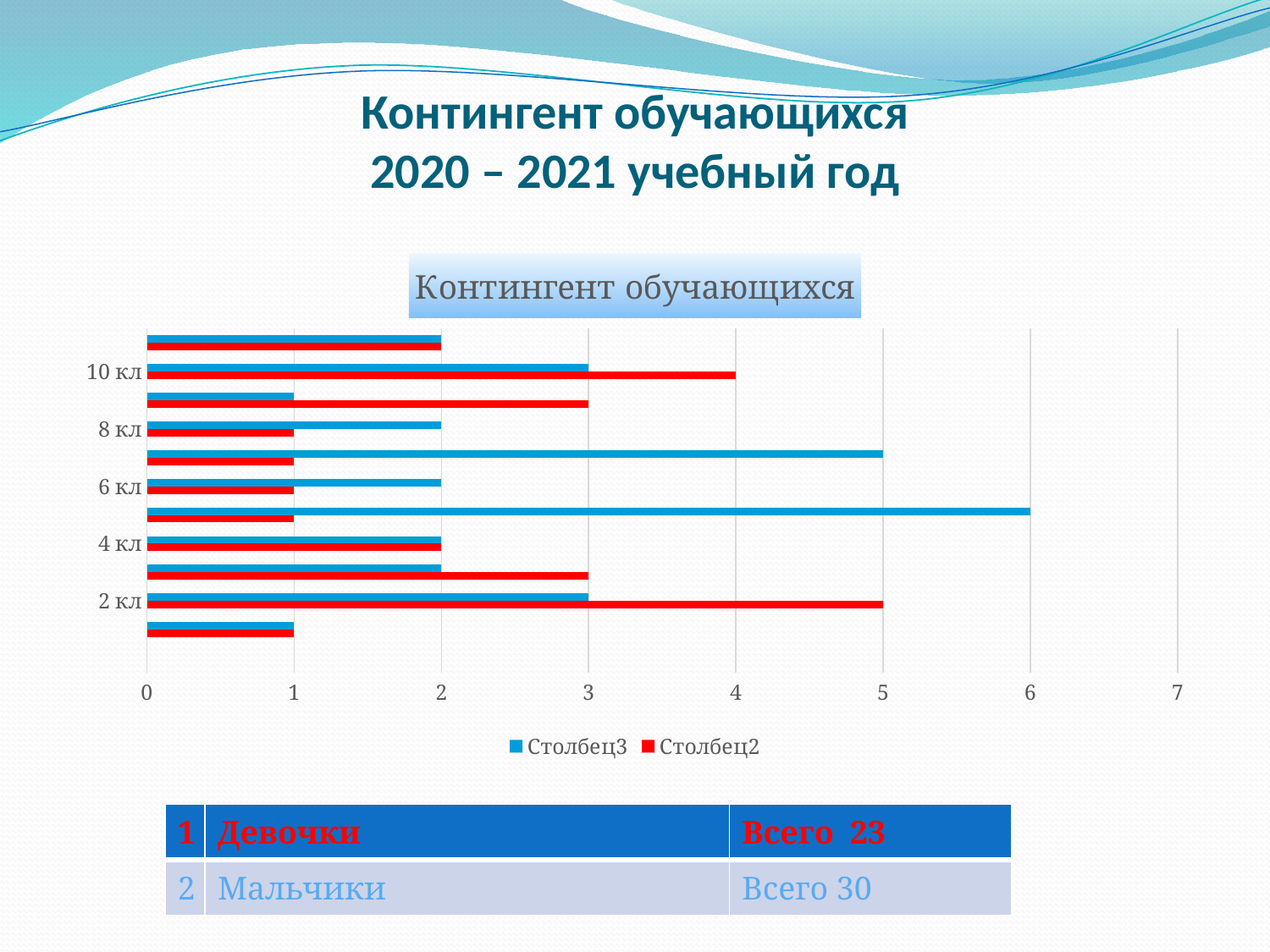
What is the value of Столбец3 for 8 кл? 2 What is the value of Столбец2 for 2 кл? 5 What type of chart is shown on the slide? bar chart What is the difference between Столбец2 and Столбец3 for 2 кл? 2 Is the value of Столбец2 for 2 кл greater or less than 4? greater How many series does the chart legend list? 2 Which labelled class has the highest value for Столбец2? 2 кл What is the value of Столбец2 for 6 кл? 1 For 2 кл, which series has the larger value, Столбец3 or Столбец2? Столбец2 What is the title of the chart? Контингент обучающихся What is the value of Столбец3 for 2 кл? 3 What is the value of Столбец2 for 10 кл? 4